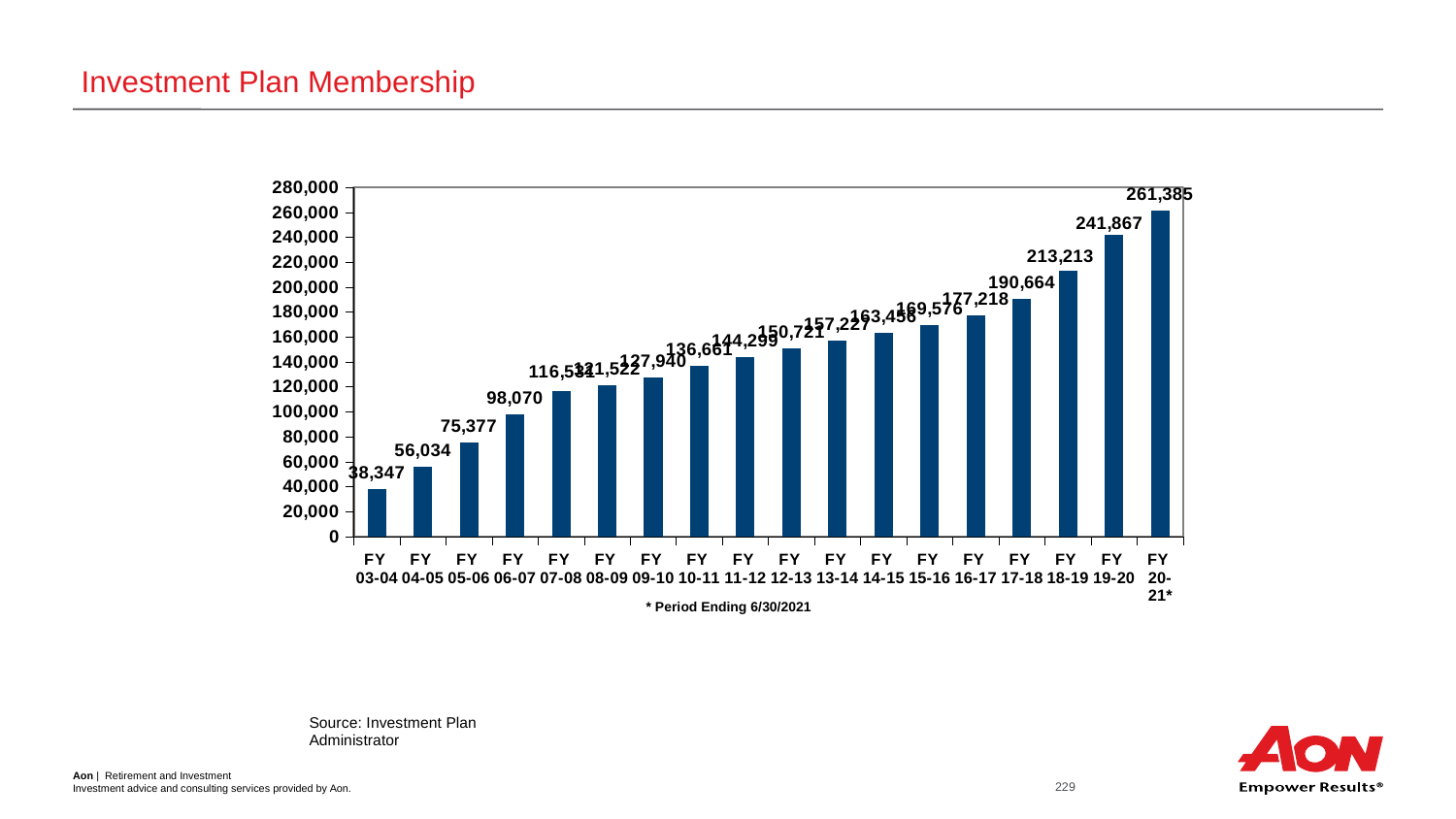
Which fiscal year has the lowest membership? FY 03-04 Is the membership for FY 07-08 greater or less than 100,000? greater How many fiscal years are shown on the chart? 18 Which fiscal year has the highest membership? FY 20-21* By how much did membership increase from FY 19-20 to FY 20-21*? 19,518 What is the Investment Plan membership for FY 03-04? 38,347 What is the difference in membership between FY 04-05 and FY 03-04? 17,687 Does membership rise or fall across the fiscal years from FY 03-04 to FY 20-21*? rise What is the membership value shown for FY 20-21*? 261,385 What type of chart is used to show Investment Plan Membership? bar chart Which has the larger membership, FY 17-18 or FY 18-19? FY 18-19 What is the membership value for FY 06-07? 98,070